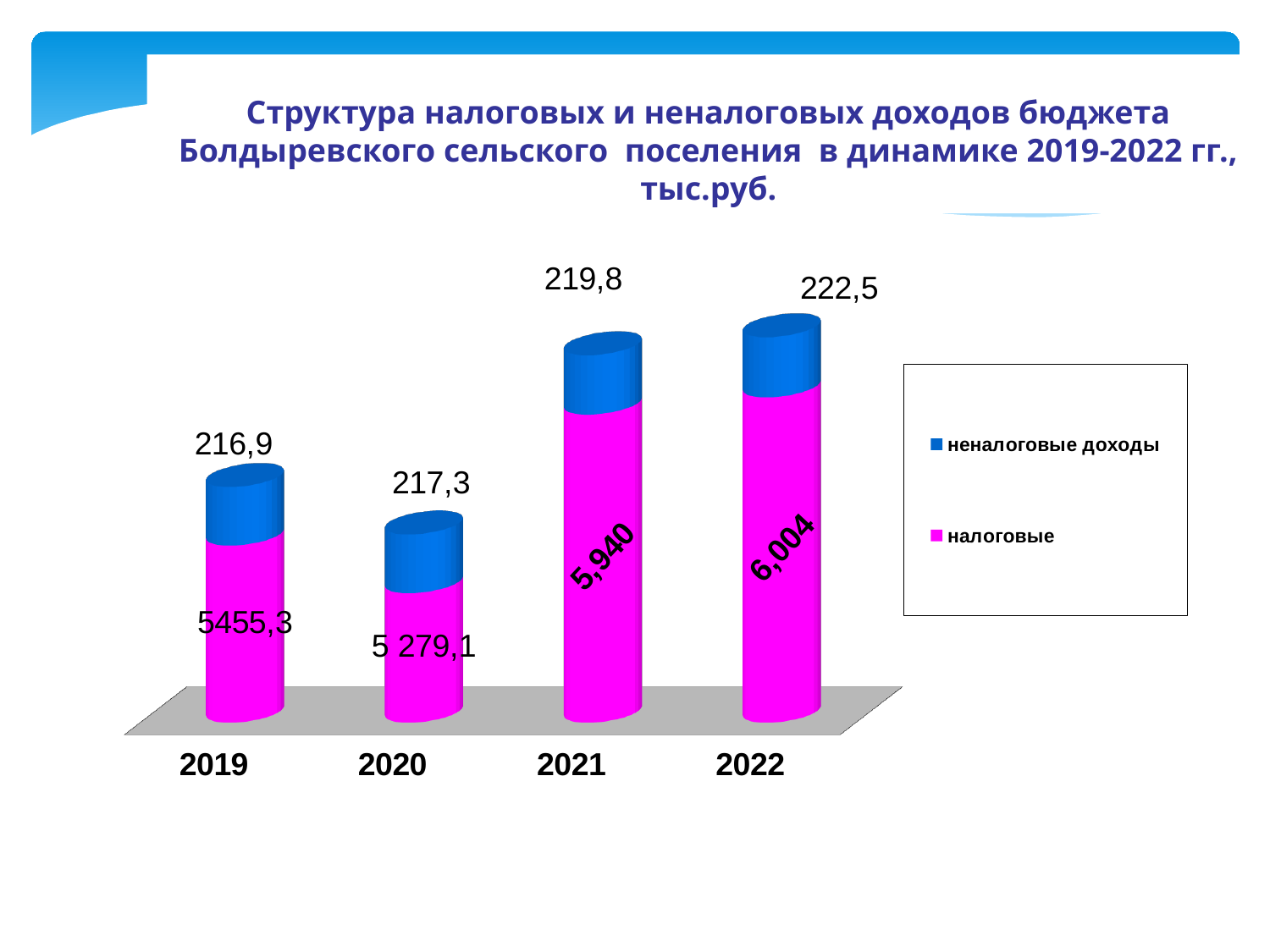
How many series does the legend list? 2 Which year has the lowest value of неналоговые доходы? 2019 What is the value of налоговые for 2021 as printed on the bar? 5,940 How many years are shown on the x axis? 4 Which year has the highest value of неналоговые доходы? 2022 What is the difference between the неналоговые доходы values for 2022 and 2019? 5,6 Do the неналоговые доходы values rise or fall from 2019 to 2022? rise Which is larger, the налоговые value for 2021 or for 2020? 2021 What is the value of неналоговые доходы for 2019? 216,9 Which year has the lowest value of налоговые? 2020 What is the value of неналоговые доходы for 2022? 222,5 What is the value of налоговые for 2020? 5 279,1